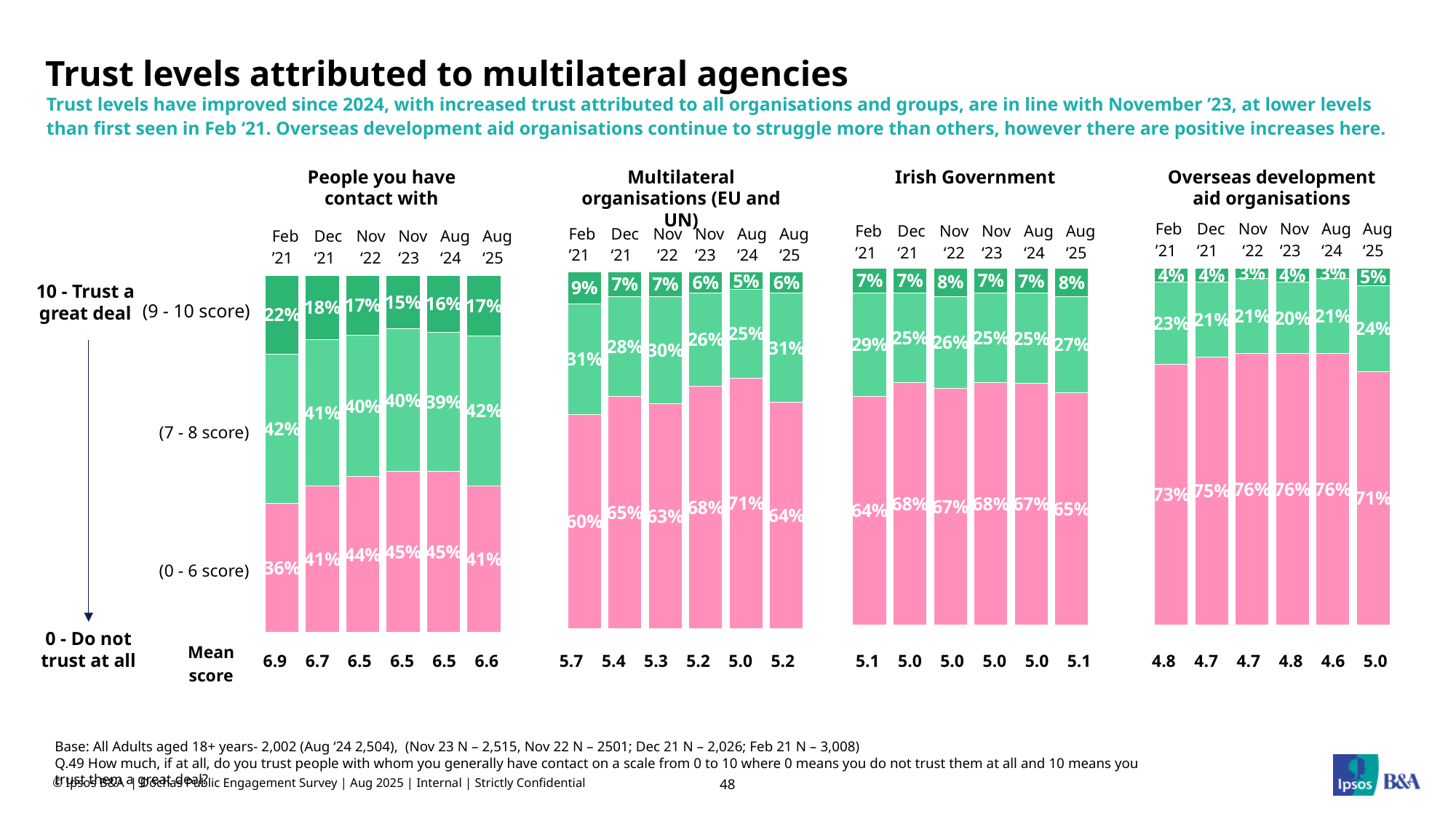
In the 'People you have contact with' chart, what percentage gave a 9-10 score in Feb '21? 22% How many survey waves are shown in each chart? 6 In the 'Overseas development aid organisations' chart, what percentage gave a 7-8 score in Aug '25? 24% What type of chart is used to show the trust levels on this slide? Stacked bar chart In the 'Irish Government' chart, is the 7-8 score percentage larger in Feb '21 or Aug '25? Feb '21 In the 'Multilateral organisations (EU and UN)' chart, what is the difference between the 0-6 score percentage in Aug '24 and Aug '25? 7% In the 'Irish Government' chart, what is the mean score for Aug '25? 5.1 In the 'Multilateral organisations (EU and UN)' chart, what percentage gave a 0-6 score in Aug '24? 71% How many charts are shown on the slide? 4 In the 'Overseas development aid organisations' chart, which wave has the lowest mean score? Aug '24 In the 'Multilateral organisations (EU and UN)' chart, does the mean score rise or fall from Feb '21 to Aug '24? Fall In the 'People you have contact with' chart, which wave has the highest mean score? Feb '21